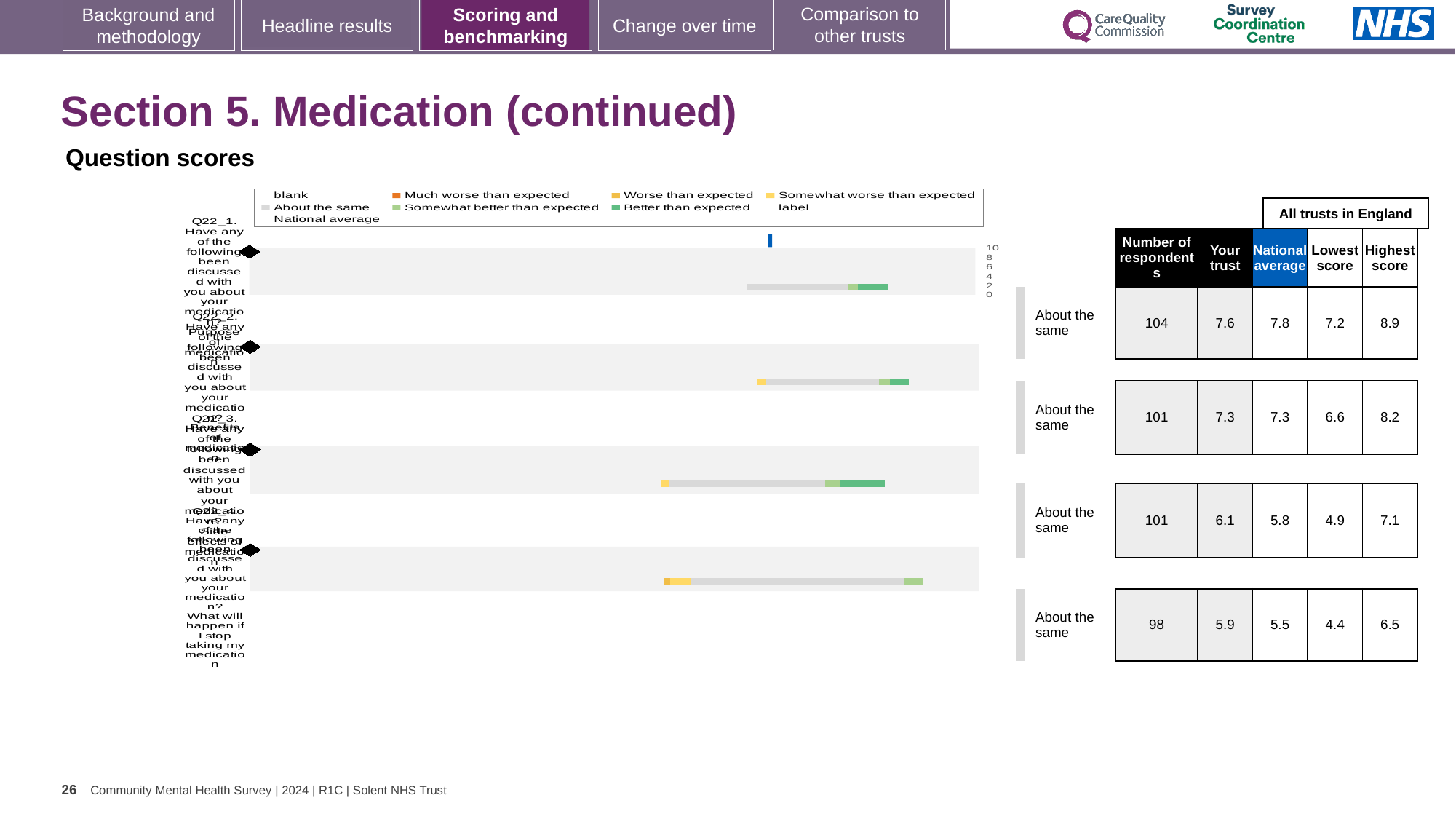
In the table next to the chart, which row has the lowest number of respondents? Q22_4 (98) In the table next to the chart, what is the national average for the fourth row (Q22_4)? 5.5 What kind of chart is shown on the slide? bar chart How many question rows (categories) are plotted in the chart? 4 In the table next to the chart, what is the 'Your trust' score for the third row (Q22_3)? 6.1 In the table next to the chart, what is the number of respondents for the first row (Q22_1)? 104 In the table next to the chart, for the first row (Q22_1), which is larger: the 'Your trust' score or the national average? National average In the table next to the chart, what is the difference between the 'Your trust' score and the national average for the third row (Q22_3)? 0.3 In the table next to the chart, what is the highest score for the first row (Q22_1)? 8.9 What benchmark category is shown for every question row on the slide? About the same What is the title of the chart section on the slide? Question scores In the table next to the chart, what is the lowest score for the second row (Q22_2)? 6.6